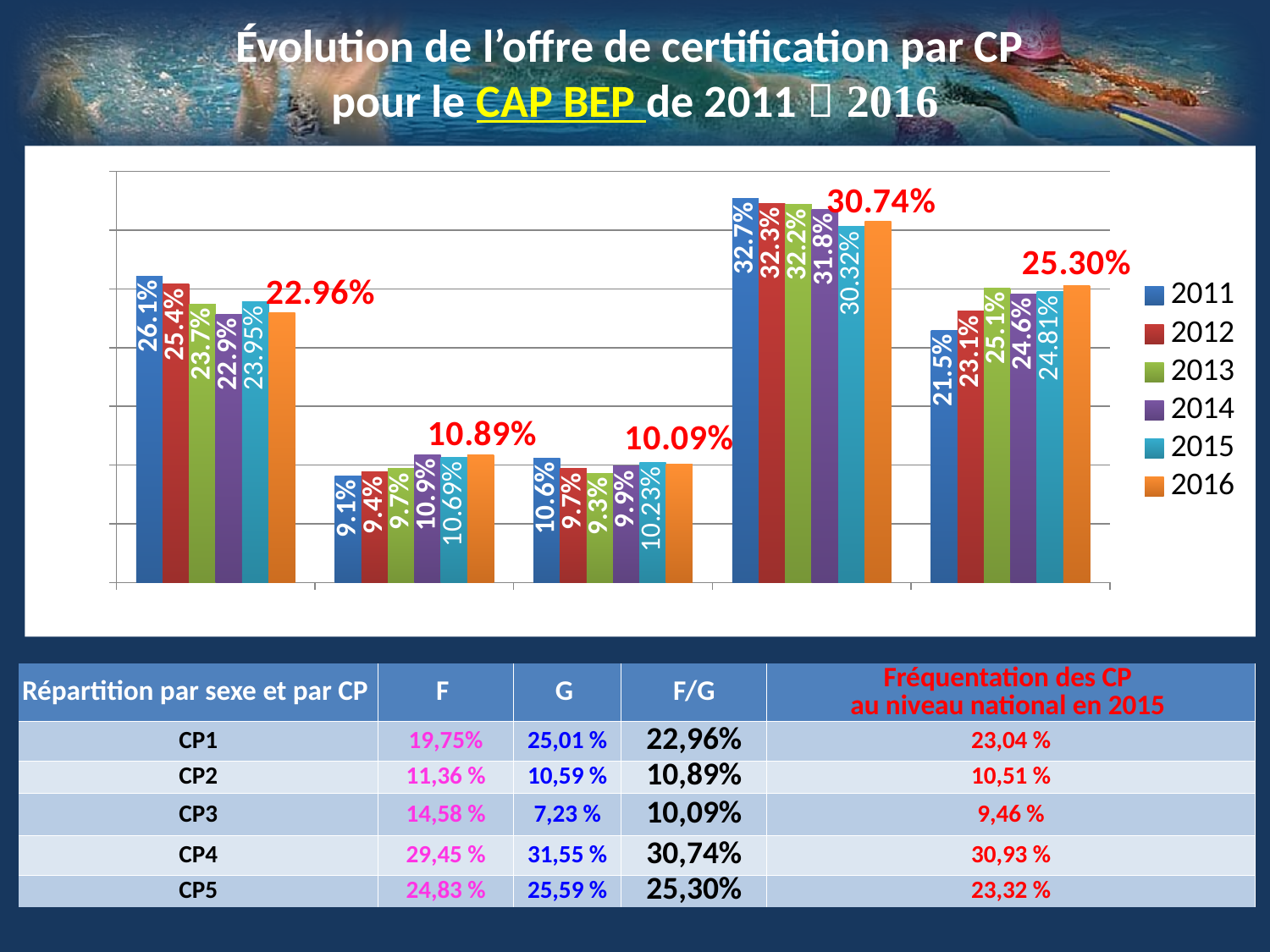
What kind of chart is shown on the slide? bar chart In the chart, which is larger in the first group of bars: the 2012 value or the 2015 value? 2012 (25.4%) In the chart, do the values in the fifth group of bars (21.5% in 2011 to 25.30% in 2016) rise or fall from 2011 to 2016? rise In the chart, which group of bars has the highest 2016 value? the fourth group (30.74%) In the chart, what is the 2014 value for the second group of bars (the group labelled 10.89% for 2016)? 10.9% How many groups of bars (categories) are plotted in the chart? 5 In the chart, which group of bars has the lowest 2016 value? the third group (10.09%) In the chart, what is the difference between the 2011 value (32.7%) and the 2016 value (30.74%) in the fourth group of bars? 1.96% In the chart, what is the 2013 value for the fifth group of bars (the group labelled 25.30% for 2016)? 25.1% How many series does the chart legend list? 6 In the chart, what is the 2015 value for the fourth group of bars (the group labelled 30.74% for 2016)? 30.32% In the chart, what is the 2011 value for the first group of bars (the group labelled 22.96% for 2016)? 26.1%